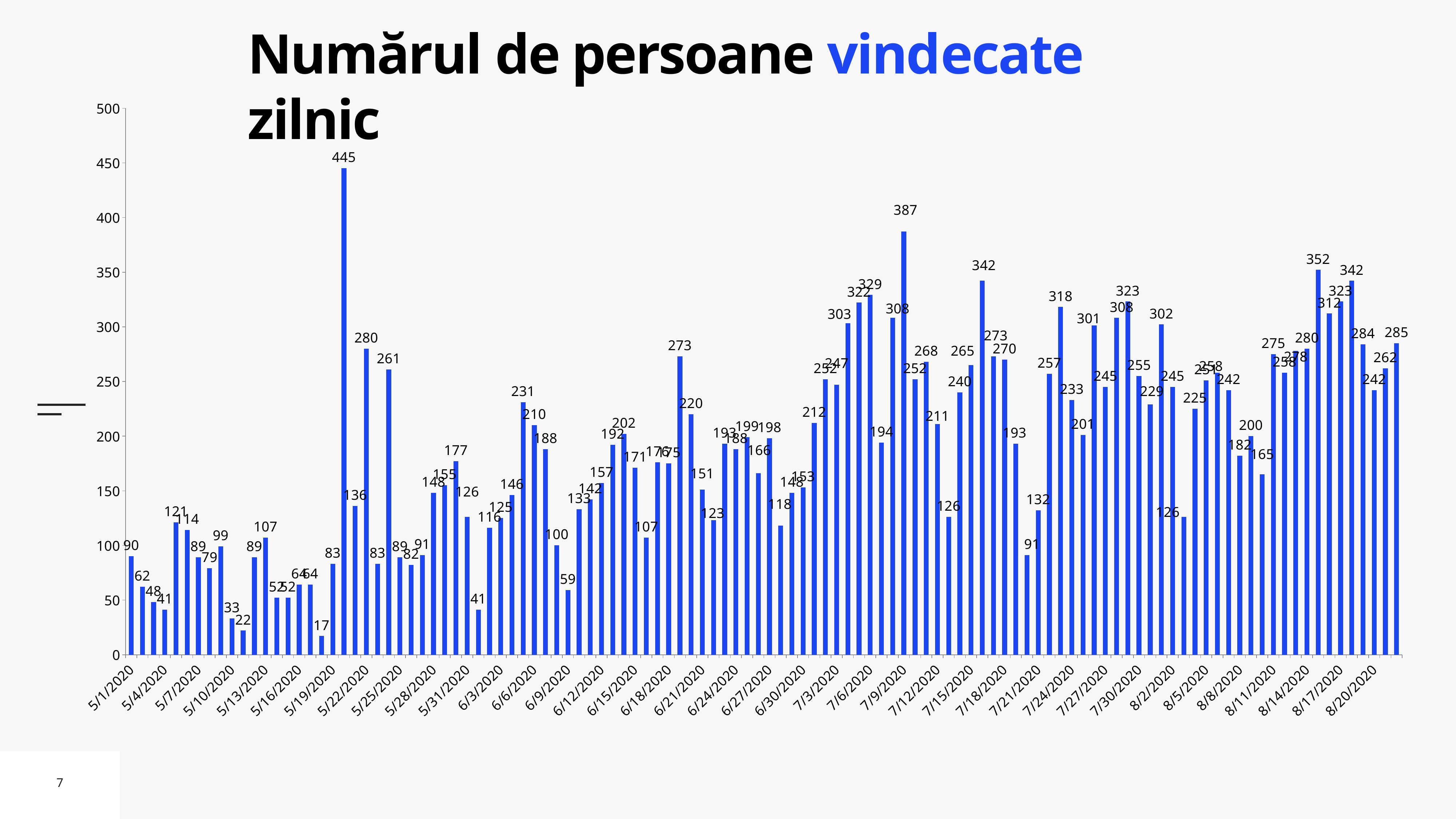
What is the title of the chart? Numărul de persoane vindecate zilnic What is the value for 5/1/2020? 90 Is the value for 7/9/2020 greater or less than 350? greater What is the difference between the highest bar (445) and the second highest bar (387)? 58 Which is larger, the value for 5/20/2020 or the value for 7/9/2020? 5/20/2020 What is the highest value shown in the chart? 445 What kind of chart is shown on the slide? bar chart What is the value of the last bar in the chart? 285 What is the value for 7/9/2020? 387 What is the lowest value shown in the chart? 17 Which date has the highest value in the chart? 5/20/2020 Overall, do the values rise or fall from May to August along the x axis? rise